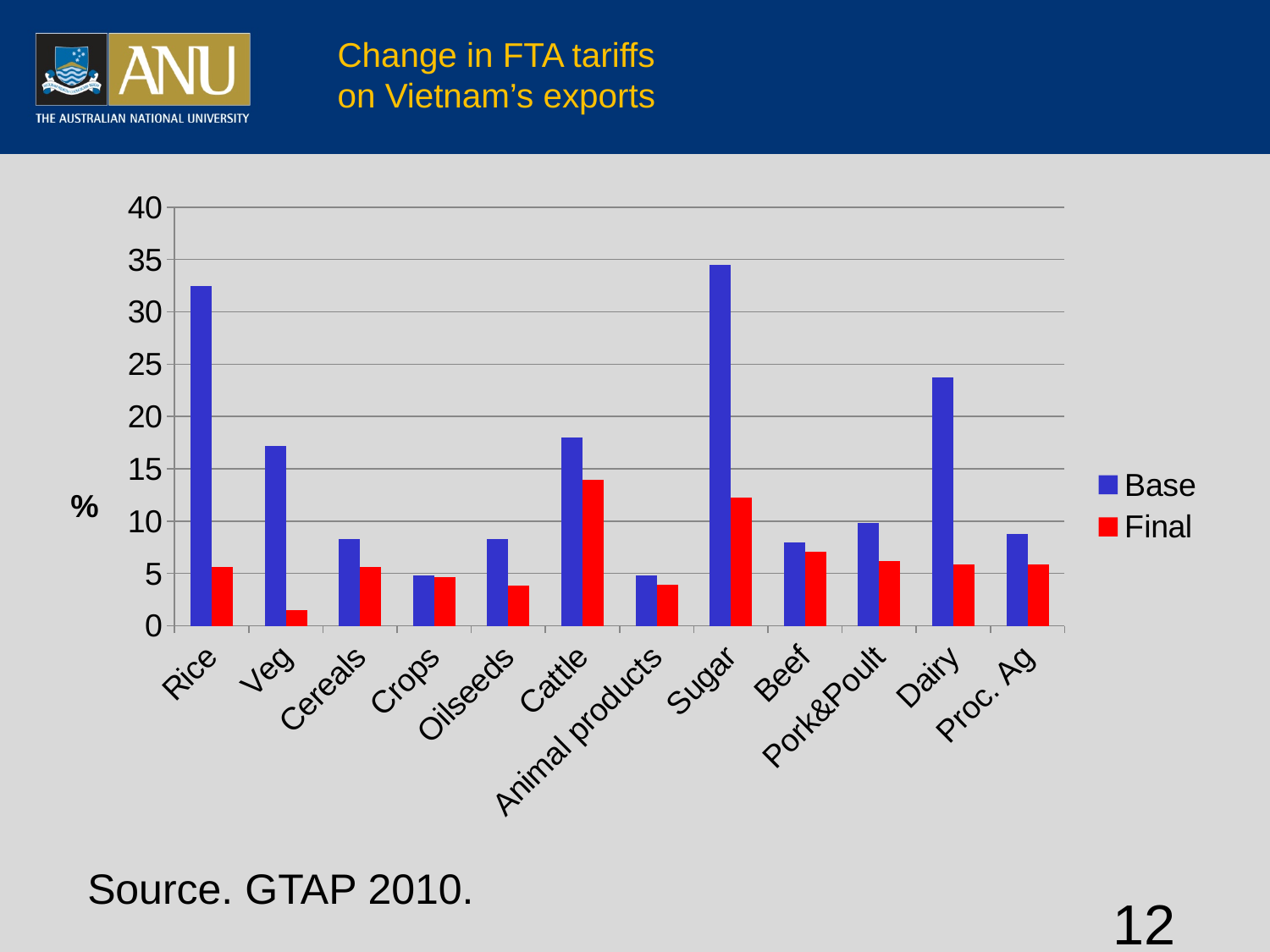
What is the title of the chart on the slide? Change in FTA tariffs on Vietnam's exports Which category has the lowest Final value? Veg How many series does the legend list? 2 Which category has the highest Base value? Sugar Which is larger for Sugar, the Base value or the Final value? Base Which category has the highest Final value? Cattle Is the Base value for Rice greater or less than 30? greater Is the Final value for Veg greater or less than 5? less What kind of chart is shown on the slide? bar chart Is the Final value for Cattle greater or less than 10? greater How many categories are shown on the x axis? 12